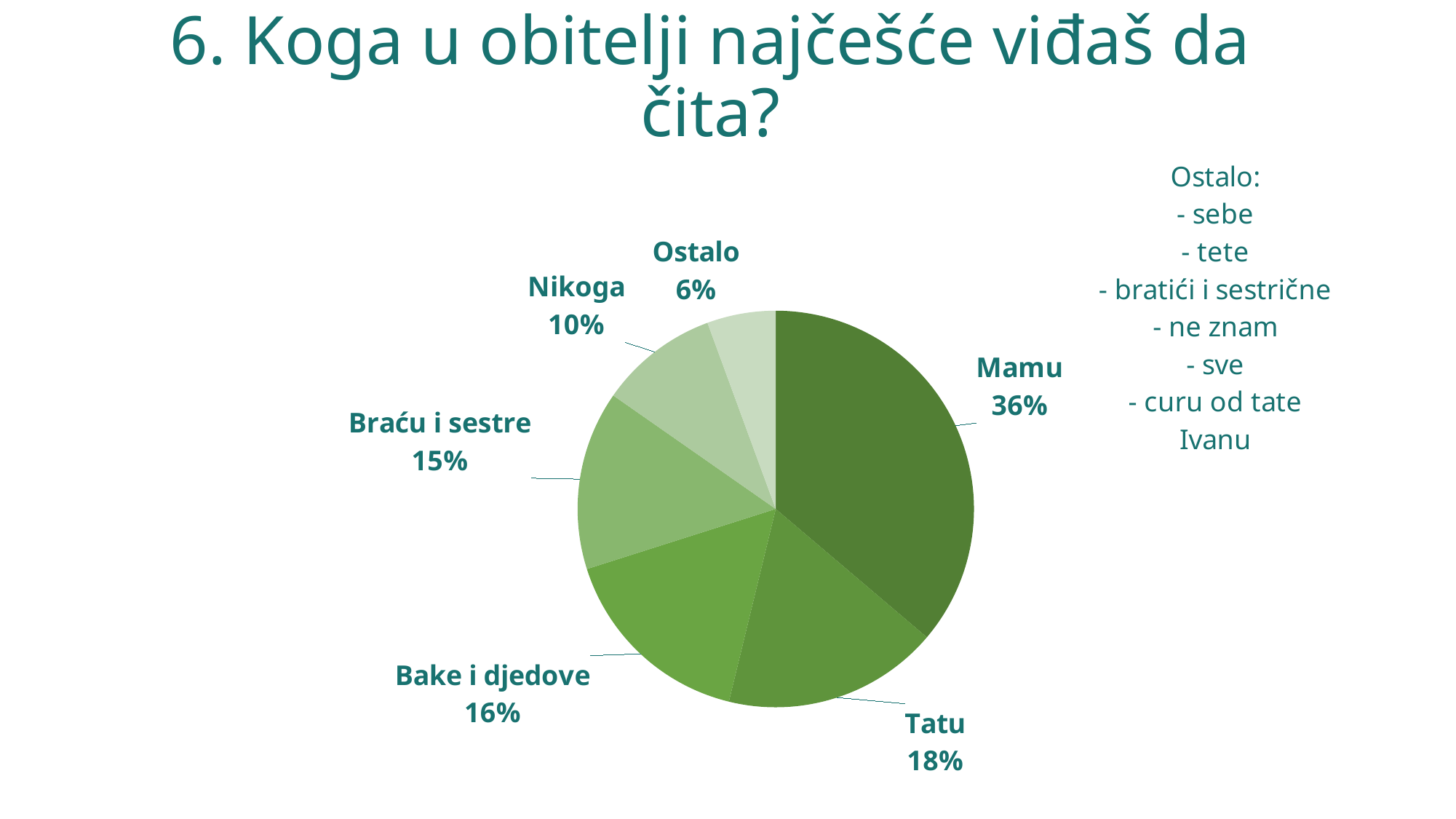
What percentage of the pie is labelled Nikoga? 10% What percentage of the pie is labelled Tatu? 18% Which category has the largest slice of the pie? Mamu How many slices does the pie chart have? 6 What is the difference in percentage points between Bake i djedove and Ostalo? 10 What percentage of the pie is labelled Mamu? 36% What is the title of the slide containing the chart? 6. Koga u obitelji najčešće viđaš da čita? What kind of chart is shown on the slide? pie chart Which slice is larger, Braću i sestre or Nikoga? Braću i sestre Which category has the smallest slice of the pie? Ostalo What percentage of the pie is labelled Bake i djedove? 16% What is the difference in percentage points between Mamu and Tatu? 18